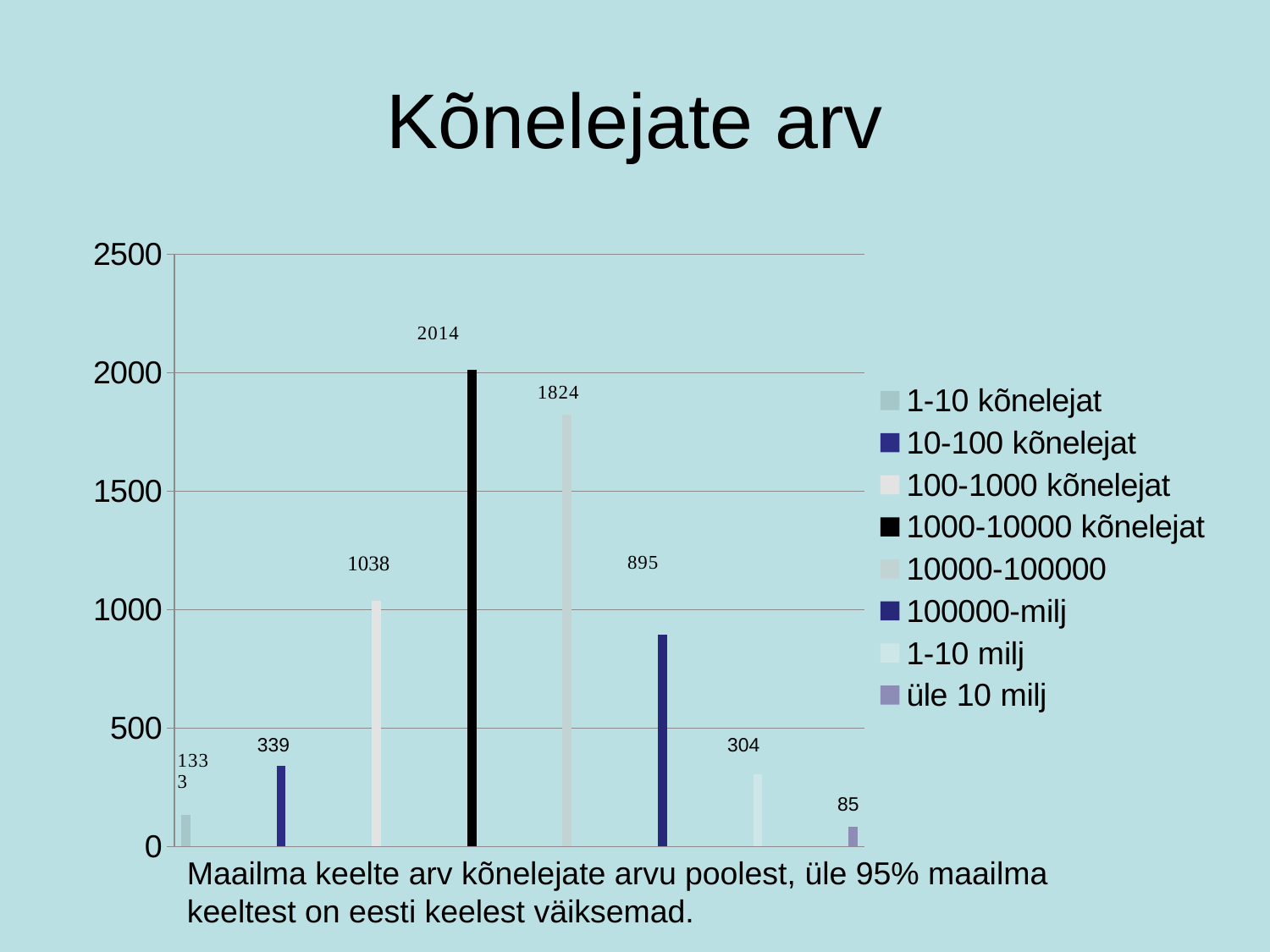
How many series does the legend list? 8 What type of chart is shown on the slide? bar chart What is the value for the 10000-100000 series? 1824 Which series has the lowest value? üle 10 milj What is the title of the chart? Kõnelejate arv Is the value for 1-10 kõnelejat greater or less than 500? less What is the value for the üle 10 milj series? 85 What is the value for the 100000-milj series? 895 What is the difference between the 1000-10000 kõnelejat value and the 10000-100000 value? 190 Which is larger, the value for 100-1000 kõnelejat or the value for 100000-milj? 100-1000 kõnelejat Which series has the highest value? 1000-10000 kõnelejat What is the value for the 1000-10000 kõnelejat series? 2014